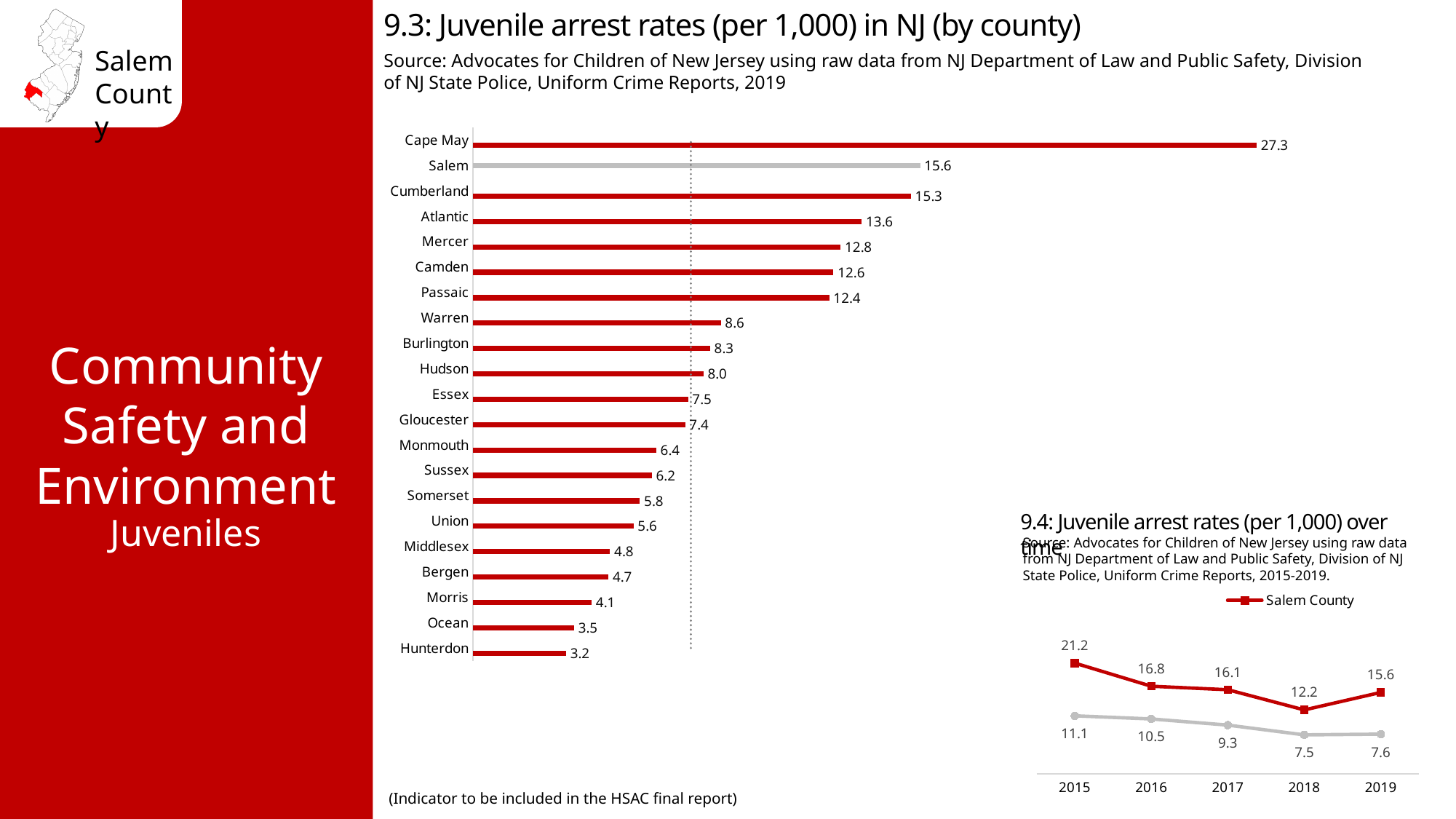
In the chart '9.3: Juvenile arrest rates (per 1,000) in NJ (by county)', which county has the lowest value? Hunterdon In the chart '9.3: Juvenile arrest rates (per 1,000) in NJ (by county)', which is larger, the value for Mercer or the value for Passaic? Mercer What kind of chart is '9.3: Juvenile arrest rates (per 1,000) in NJ (by county)'? Bar chart In the chart '9.4: Juvenile arrest rates (per 1,000) over time', what is the Salem County value for 2018? 12.2 In the chart '9.3: Juvenile arrest rates (per 1,000) in NJ (by county)', how many counties are shown? 21 In the chart '9.3: Juvenile arrest rates (per 1,000) in NJ (by county)', what is the value for Gloucester? 7.4 In the chart '9.4: Juvenile arrest rates (per 1,000) over time', how many years are shown on the x axis? 5 In the chart '9.3: Juvenile arrest rates (per 1,000) in NJ (by county)', what is the value for Salem? 15.6 In the chart '9.4: Juvenile arrest rates (per 1,000) over time', what is the difference between the Salem County values for 2015 and 2019? 5.6 In the chart '9.4: Juvenile arrest rates (per 1,000) over time', in which year is the Salem County value highest? 2015 In the chart '9.3: Juvenile arrest rates (per 1,000) in NJ (by county)', which county has the highest value? Cape May In the chart '9.3: Juvenile arrest rates (per 1,000) in NJ (by county)', what is the difference between Cape May and Salem? 11.7